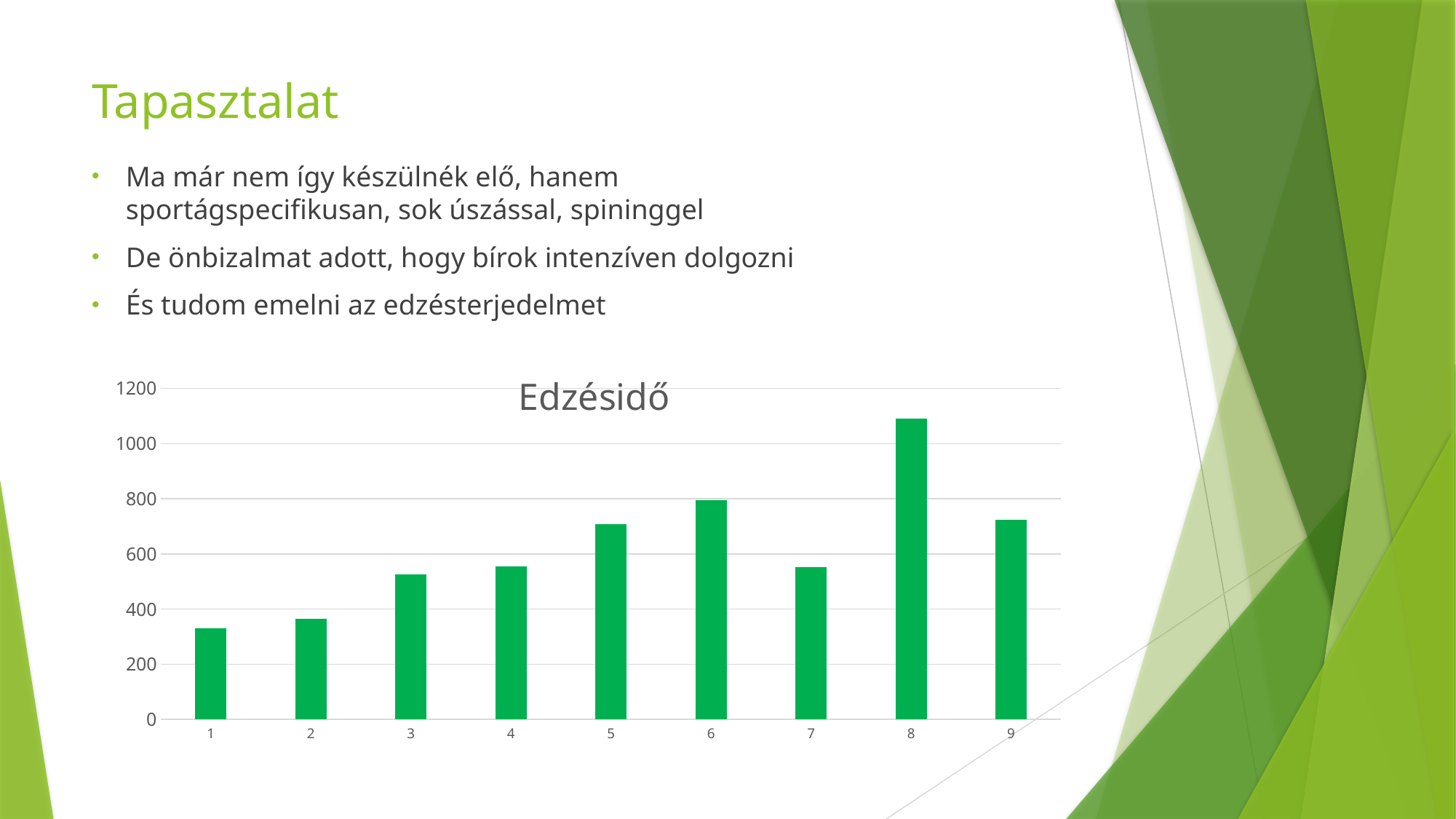
What is the title of the chart? Edzésidő Is the value for category 7 greater or less than 600? less Which has the larger value, category 6 or category 7? 6 Is the value for category 5 greater or less than 600? greater Do the values rise or fall from category 1 to category 6? rise How many categories are plotted on the x axis of the chart? 9 What kind of chart is shown on the slide? bar chart Which has the larger value, category 5 or category 3? 5 Which category has the highest value in the chart? 8 Which category has the lowest value in the chart? 1 Is the value for category 1 greater or less than 400? less